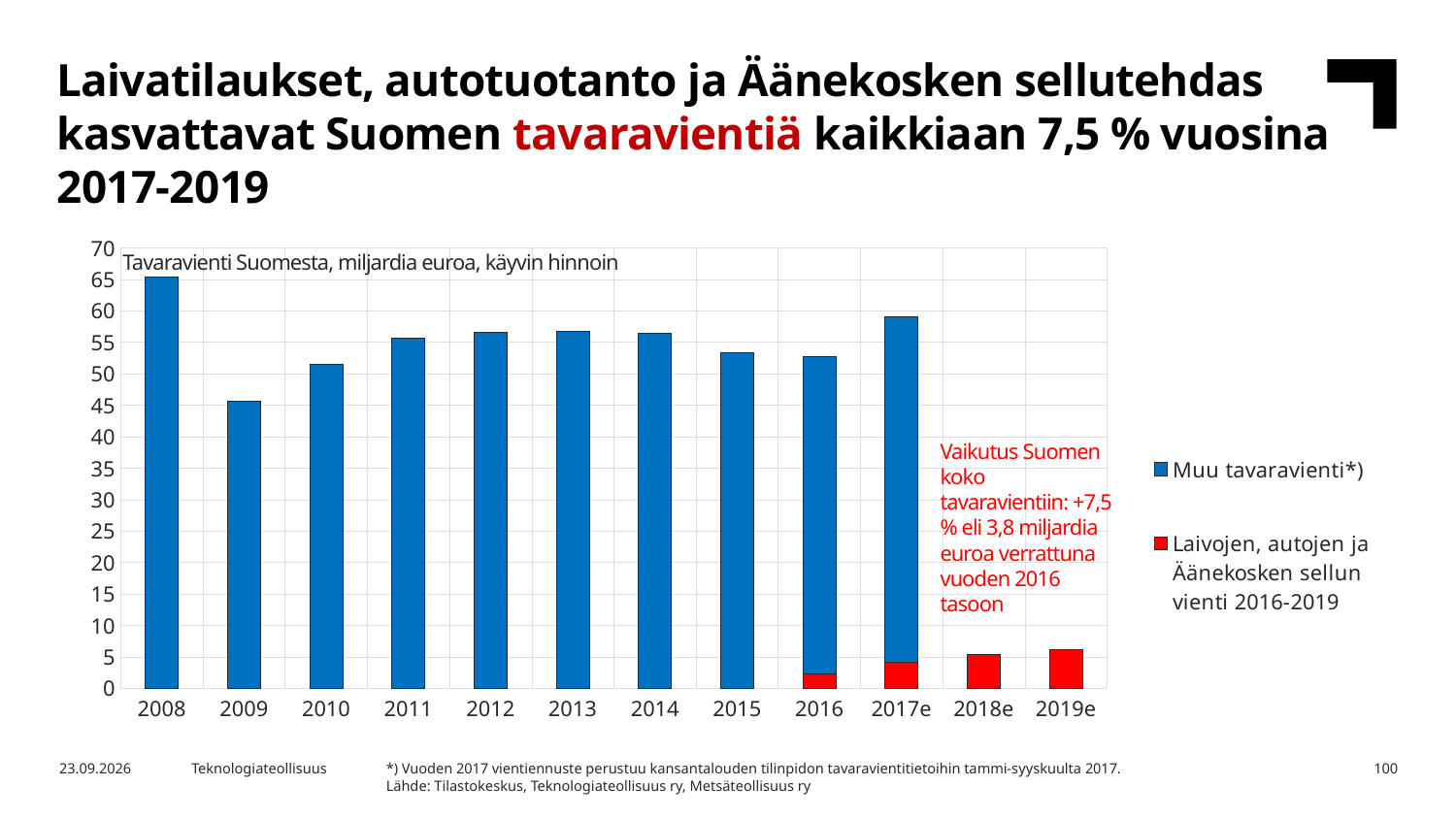
What is the title text shown inside the chart area? Tavaravienti Suomesta, miljardia euroa, käyvin hinnoin Is the red 'Laivojen, autojen ja Äänekosken sellun vienti 2016-2019' value for 2016 greater or less than 5? less Is the total value for 2009 greater or less than 50? less What kind of chart is shown on the slide? Bar chart Which year has the larger total bar, 2016 or 2017e? 2017e Is the total value for 2017e greater or less than 55? greater How many years (categories) are shown on the x axis of the chart? 12 Does the total goods export value rise or fall from 2008 to 2009? Fall Among the years 2008 to 2017e, which year has the lowest total bar? 2009 How many series does the chart legend list? 2 Which year has the highest total goods export bar in the chart? 2008